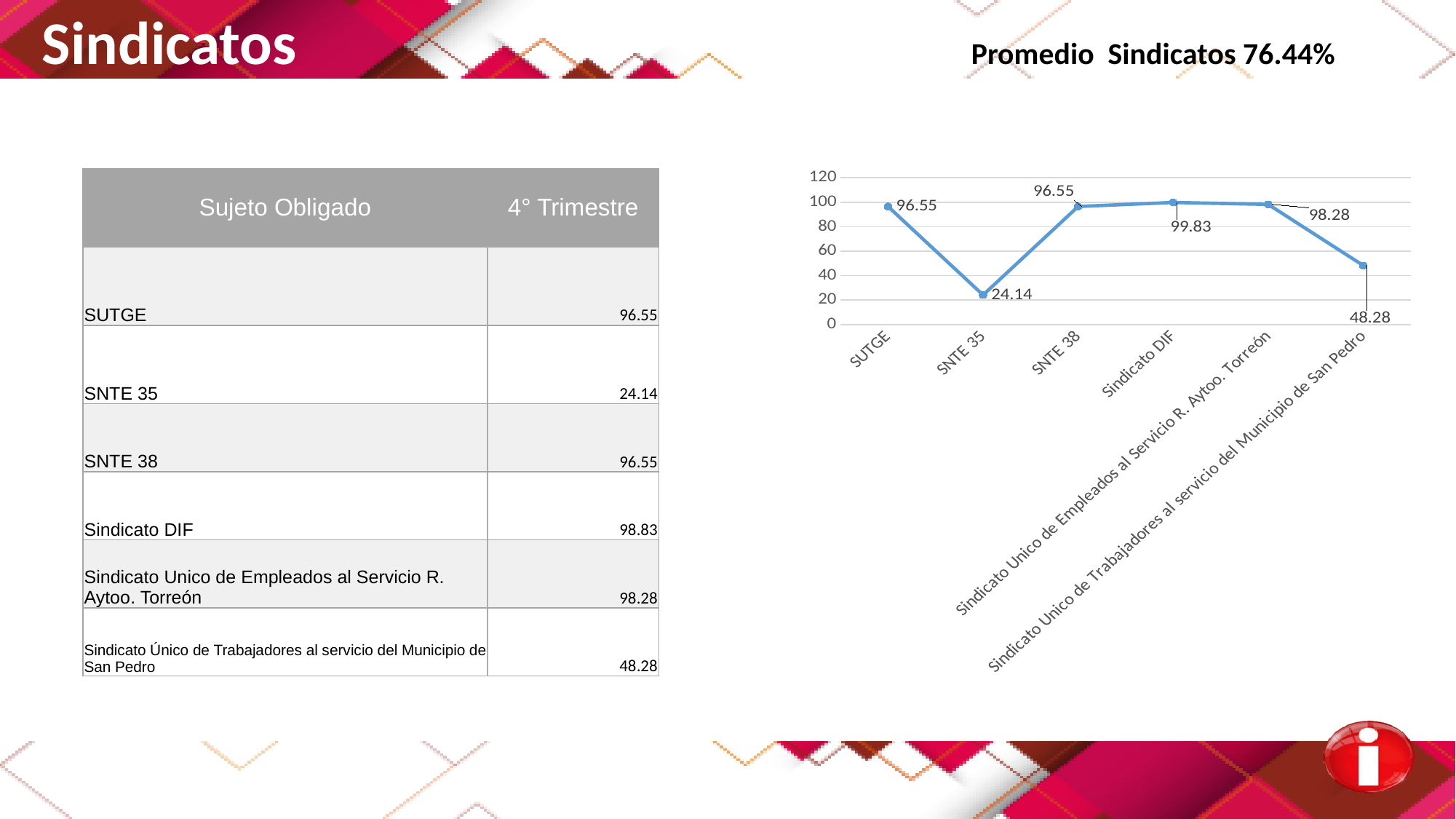
What is the value plotted for SNTE 35? 24.14 Does the line rise or fall from SUTGE to SNTE 35? fall Which category has the highest value in the chart? Sindicato DIF Which category has the lowest value in the chart? SNTE 35 How many categories are plotted on the x axis of the chart? 6 What is the value plotted for SUTGE? 96.55 What is the difference between the values for SUTGE and SNTE 35? 72.41 What is the value plotted for Sindicato Unico de Empleados al Servicio R. Aytoo. Torreón? 98.28 Which has the larger value, SNTE 38 or Sindicato Unico de Trabajadores al servicio del Municipio de San Pedro? SNTE 38 Is the value for Sindicato Unico de Trabajadores al servicio del Municipio de San Pedro greater or less than 60? less What kind of chart is shown on the slide? line chart What is the value plotted for Sindicato Unico de Trabajadores al servicio del Municipio de San Pedro? 48.28